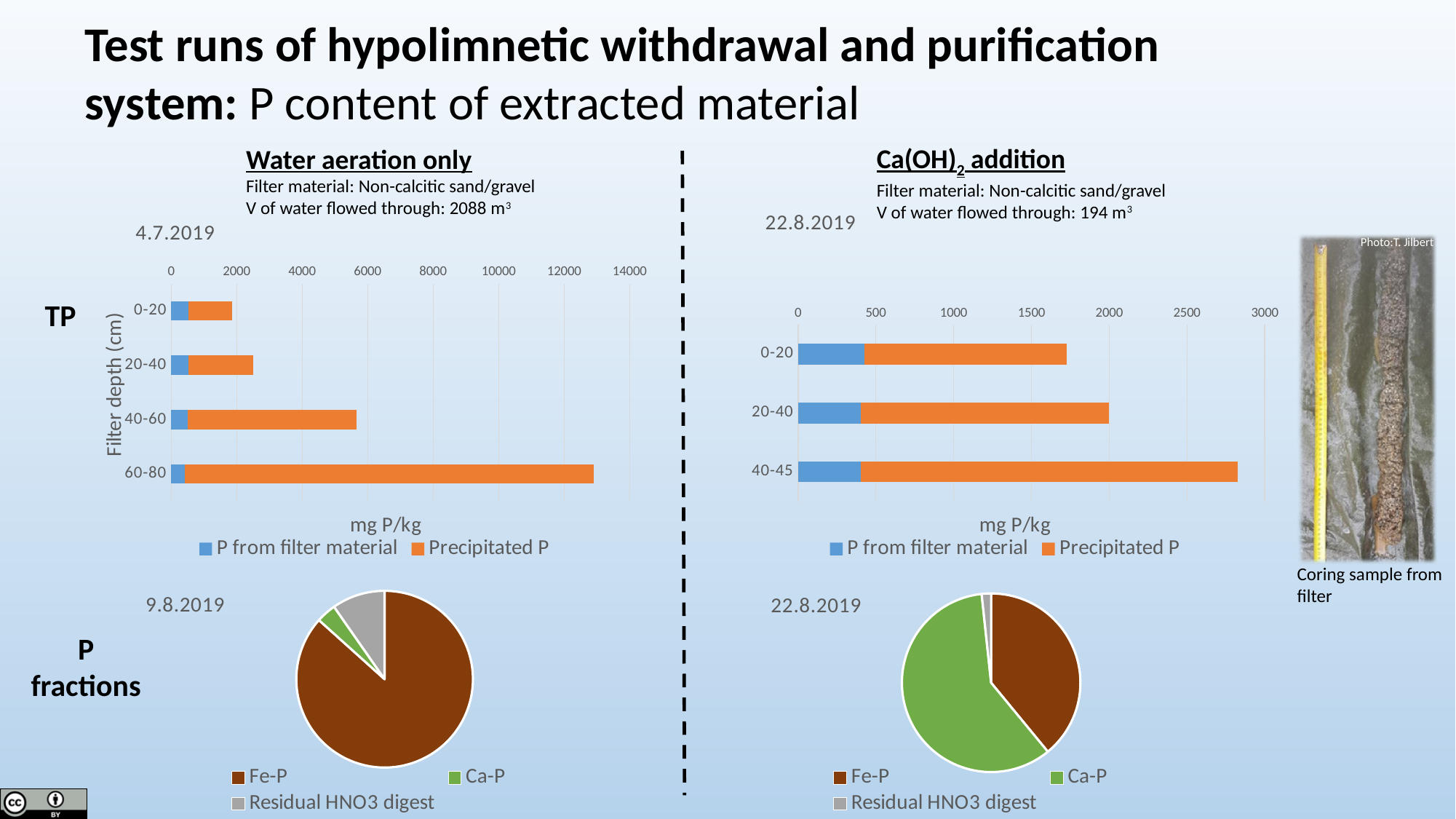
In the 'Ca(OH)2 addition' TP bar chart, which filter depth has the highest total mg P/kg? 40-45 In the 'Water aeration only' TP bar chart, is the total value for the 40-60 depth greater or less than 4000? greater In the 'Water aeration only' TP bar chart, is the total value for the 60-80 depth greater or less than 12000? greater What kind of chart is the 'Water aeration only' TP chart dated 4.7.2019? Stacked bar chart In the 'Ca(OH)2 addition' TP bar chart, is the total value for the 40-45 depth greater or less than 2500? greater In the 'Water aeration only' TP bar chart, which filter depth has the lowest total mg P/kg? 0-20 In the 'Water aeration only' TP bar chart, which filter depth has the highest total mg P/kg? 60-80 In the 'Ca(OH)2 addition' TP bar chart, how many filter depth categories are shown? 3 In the 'Water aeration only' TP bar chart, how many filter depth categories are shown? 4 In the P fractions pie chart dated 22.8.2019 (Ca(OH)2 addition), which fraction has the largest share? Ca-P How many series does the legend of the 'Water aeration only' TP bar chart list? 2 In the 'Water aeration only' TP bar chart, do total values rise or fall as filter depth increases from 0-20 to 60-80? rise